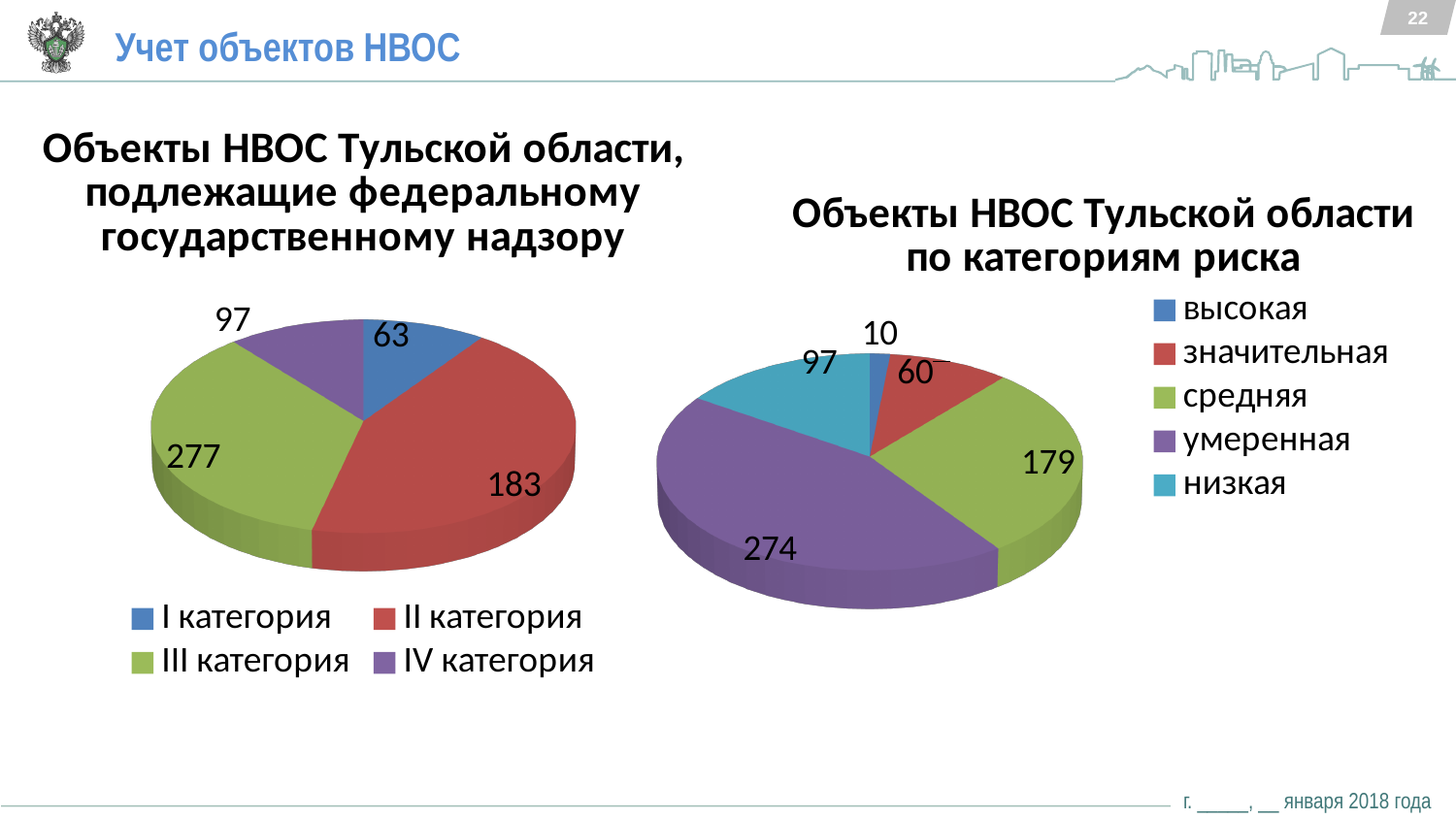
What type of chart is used on the left of the slide, titled 'Объекты НВОС Тульской области, подлежащие федеральному государственному надзору'? Pie chart In the right pie chart (risk categories), which is larger: 'умеренная' or 'низкая'? умеренная In the left pie chart (federal state supervision), what is the difference between 'III категория' and 'IV категория'? 180 In the left pie chart (federal state supervision), what is the value for 'II категория'? 183 In the left pie chart (federal state supervision), which category has the lowest value? I категория How many categories does the left pie chart (federal state supervision) show? 4 How many entries does the legend of the right pie chart (risk categories) list? 5 In the right pie chart ('Объекты НВОС Тульской области по категориям риска'), what is the value for 'средняя'? 179 In the right pie chart (risk categories), what is the difference between 'умеренная' and 'средняя'? 95 In the right pie chart (risk categories), what colour is the 'низкая' slice? Light blue (teal) In the right pie chart (risk categories), which category has the lowest value? высокая In the left pie chart (federal state supervision), which category has the highest value? III категория